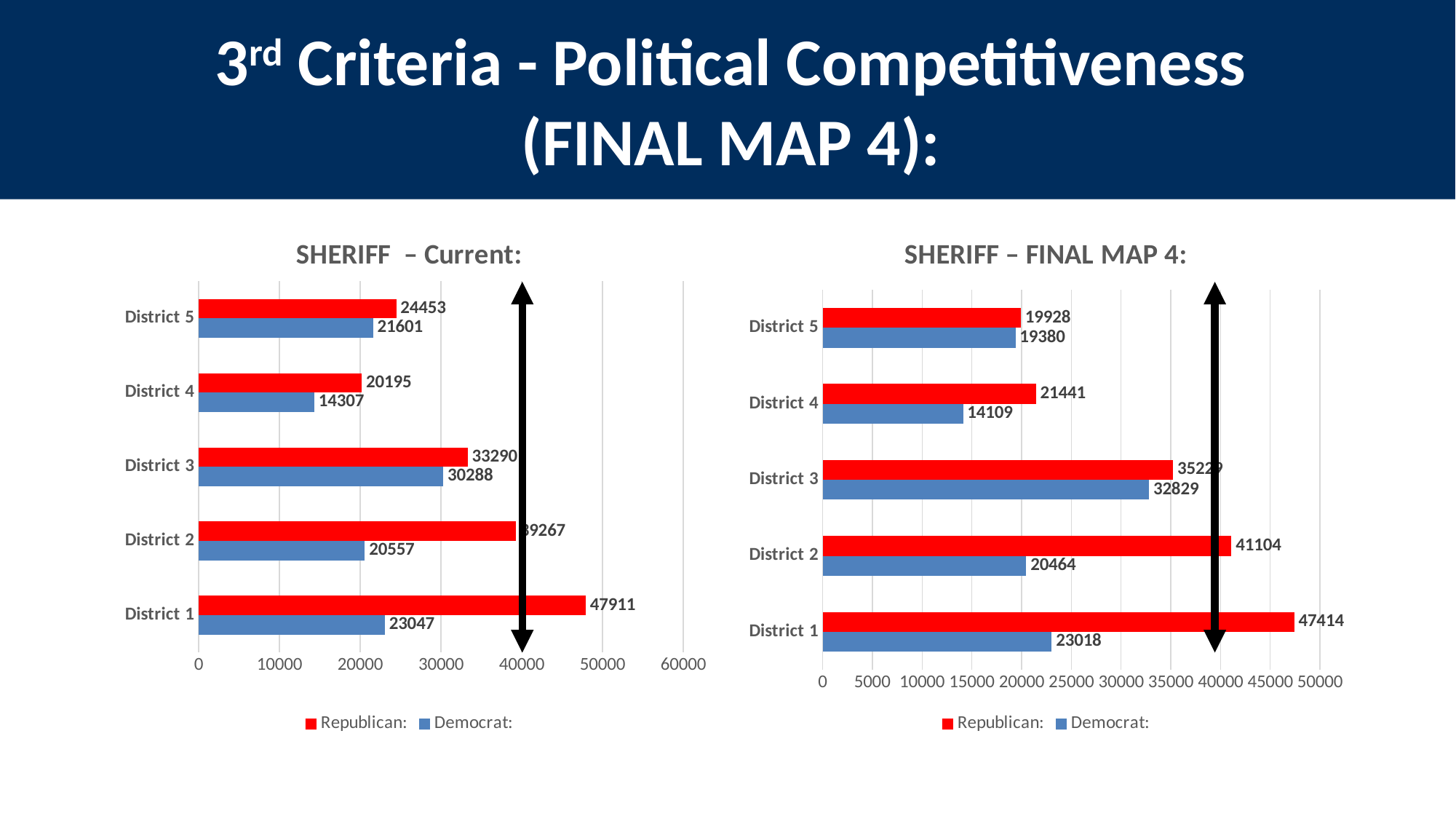
In the SHERIFF – FINAL MAP 4 chart, what is the difference between the Republican and Democrat values for District 5? 548 In the SHERIFF – FINAL MAP 4 chart, what is the Democrat value for District 3? 32829 In the SHERIFF – FINAL MAP 4 chart, which district has the lowest Democrat value? District 4 In the SHERIFF – Current chart, what is the difference between the Republican and Democrat values for District 3? 3002 In the SHERIFF – FINAL MAP 4 chart, which is larger for District 2: the Republican value or the Democrat value? Republican In the SHERIFF – FINAL MAP 4 chart, what is the Republican value for District 5? 19928 In the SHERIFF – Current chart, what is the Republican value for District 1? 47911 How many districts are shown in the SHERIFF – Current chart? 5 In the SHERIFF – Current chart, what is the Democrat value for District 4? 14307 What type of chart is the SHERIFF – Current chart? Bar chart How many series does the legend of the SHERIFF – FINAL MAP 4 chart list? 2 In the SHERIFF – Current chart, which district has the highest Republican value? District 1